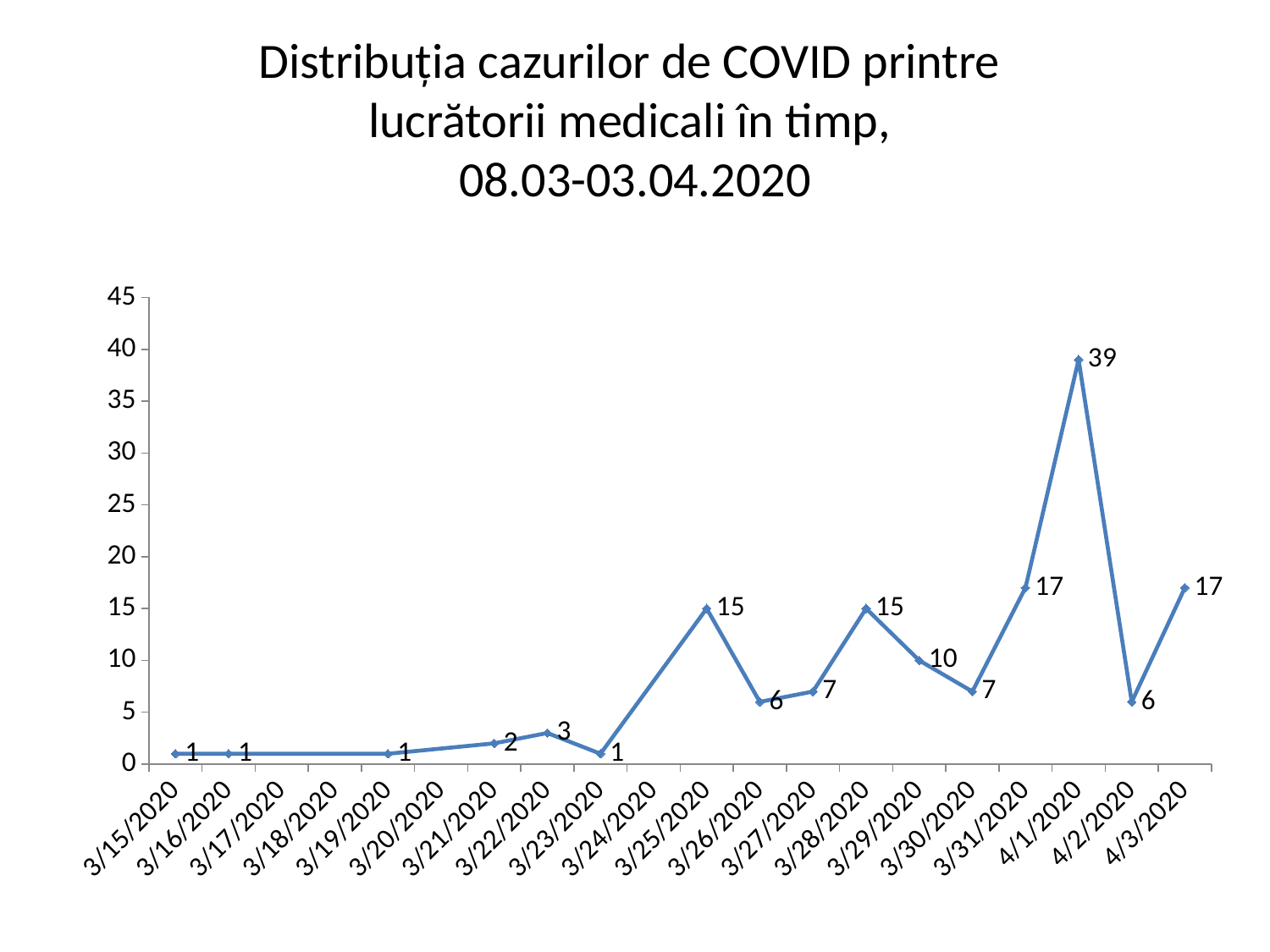
What kind of chart is shown on the slide? line chart What is the value for 3/25/2020? 15 What is the value for 3/22/2020? 3 What is the difference between the values for 4/1/2020 and 4/2/2020? 33 What is the value for 4/3/2020? 17 Which has the larger value, 3/29/2020 or 3/30/2020? 3/29/2020 On which date is the value highest? 4/1/2020 Does the value rise or fall from 3/31/2020 to 4/1/2020? rise What is the difference between the values for 3/31/2020 and 3/30/2020? 10 What is the value for 4/1/2020? 39 What is the highest value shown on the vertical axis? 45 Is the value for 4/1/2020 greater or less than 35? greater